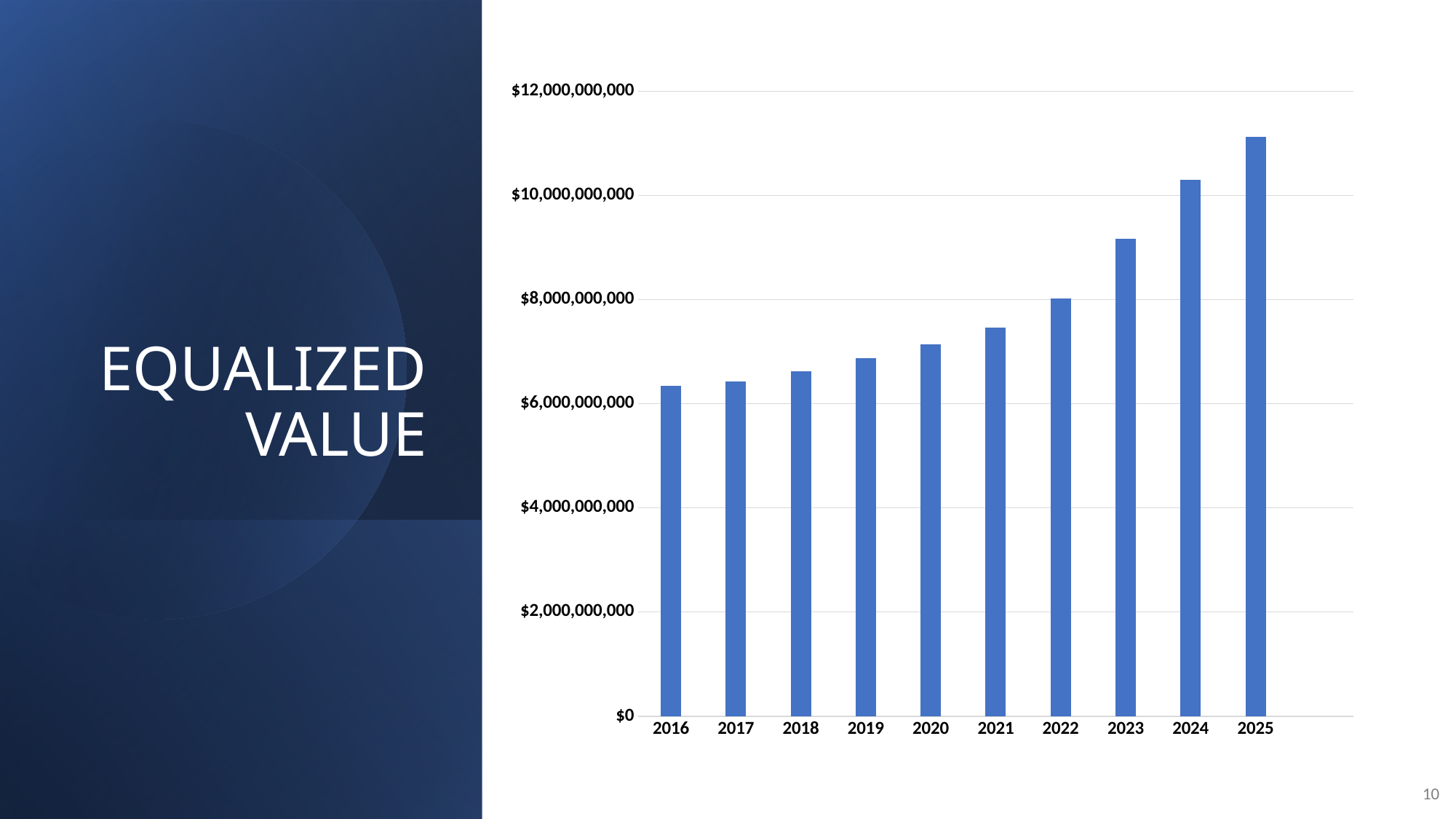
Which year has the lowest equalized value? 2016 What kind of chart is shown on the slide? bar chart What is the title shown on the slide for this chart? EQUALIZED VALUE Which is larger, the value for 2020 or the value for 2023? 2023 Is the value for 2021 greater or less than $8,000,000,000? less Do the values rise or fall from 2016 to 2025? rise Which year has the highest equalized value? 2025 How many years are shown on the x axis of the chart? 10 Is the value for 2016 greater or less than $6,000,000,000? greater Is the value for 2025 greater or less than $10,000,000,000? greater Which is larger, the value for 2025 or the value for 2016? 2025